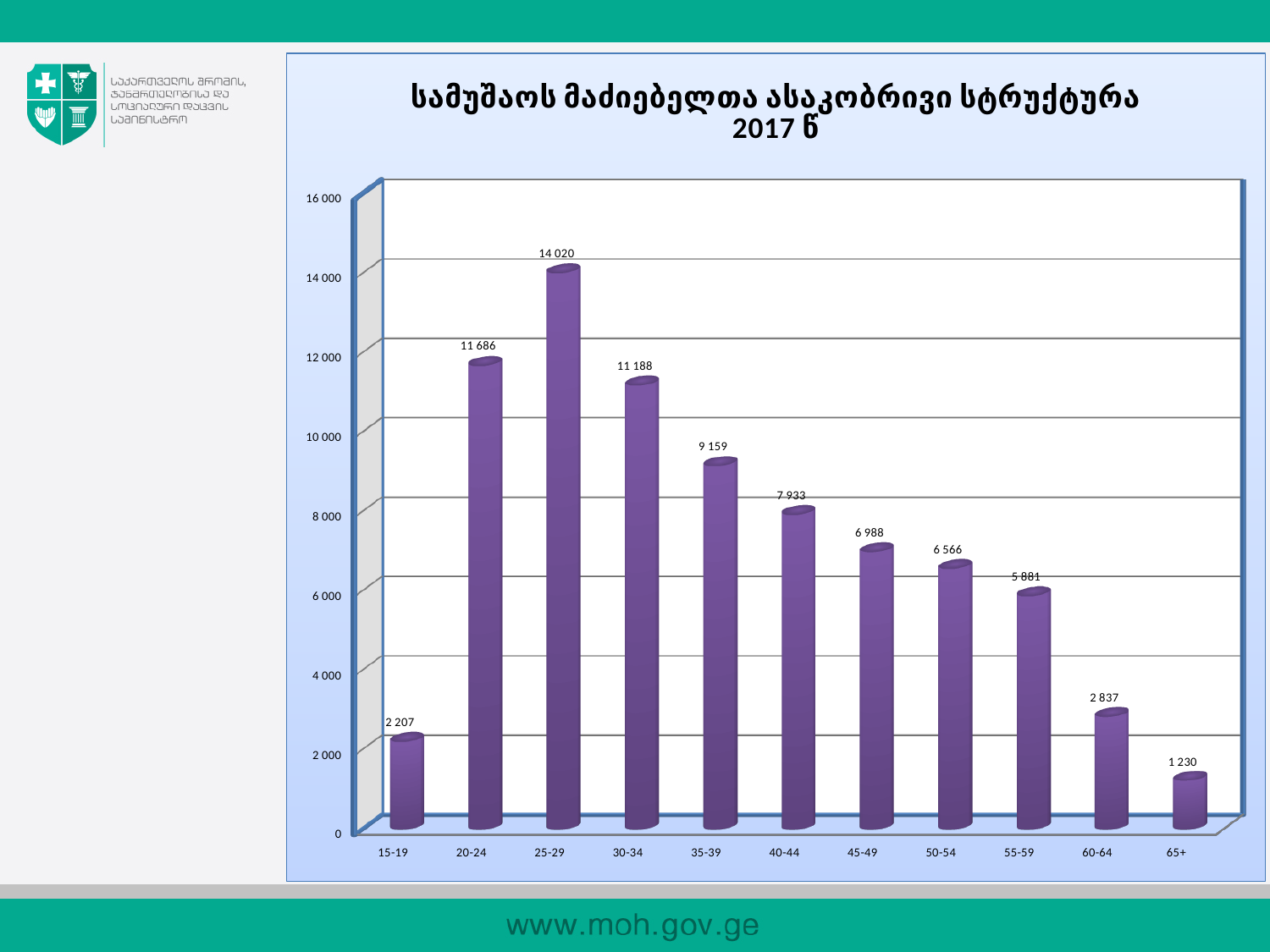
Do the values rise or fall from the 25-29 age group to the 65+ age group? fall What kind of chart is shown on the slide? bar chart Which age group has the highest value? 25-29 How many age groups are shown on the x axis? 11 Is the value for 35-39 greater or less than 8 000? greater What is the value for the 25-29 age group? 14 020 What is the value for the 65+ age group? 1 230 Which age group has the lowest value? 65+ What is the difference between the values for 20-24 and 30-34? 498 Which is larger, the value for 45-49 or the value for 50-54? 45-49 What is the value for the 40-44 age group? 7 933 What is the difference between the values for 60-64 and 65+? 1 607